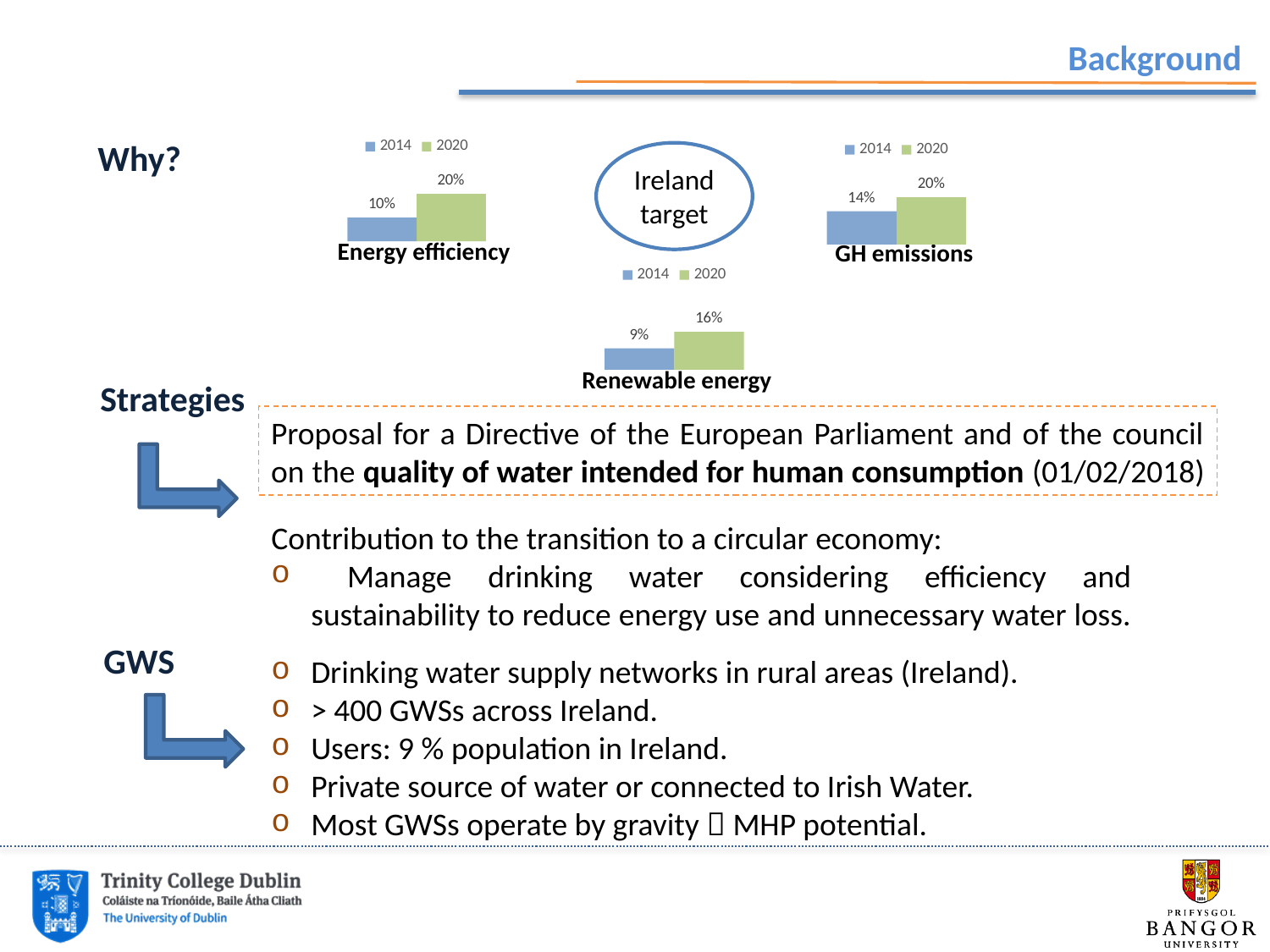
In the Renewable energy chart, which is larger, the 2014 value or the 2020 value? 2020 What are the two legend entries in the GH emissions chart? 2014 and 2020 What kind of chart is the Renewable energy chart? Bar chart How many series does the legend of the Energy efficiency chart list? 2 In the Energy efficiency chart, what is the value for 2020? 20% In the Energy efficiency chart, what is the value for 2014? 10% In the GH emissions chart, which series has the lowest value? 2014 In the GH emissions chart, what is the difference between the 2020 and 2014 values? 6% In the GH emissions chart, what is the value for 2014? 14% In the Energy efficiency chart, what is the difference between the 2020 and 2014 values? 10% In the Renewable energy chart, what is the value for 2014? 9% In the Renewable energy chart, what is the value for 2020? 16%